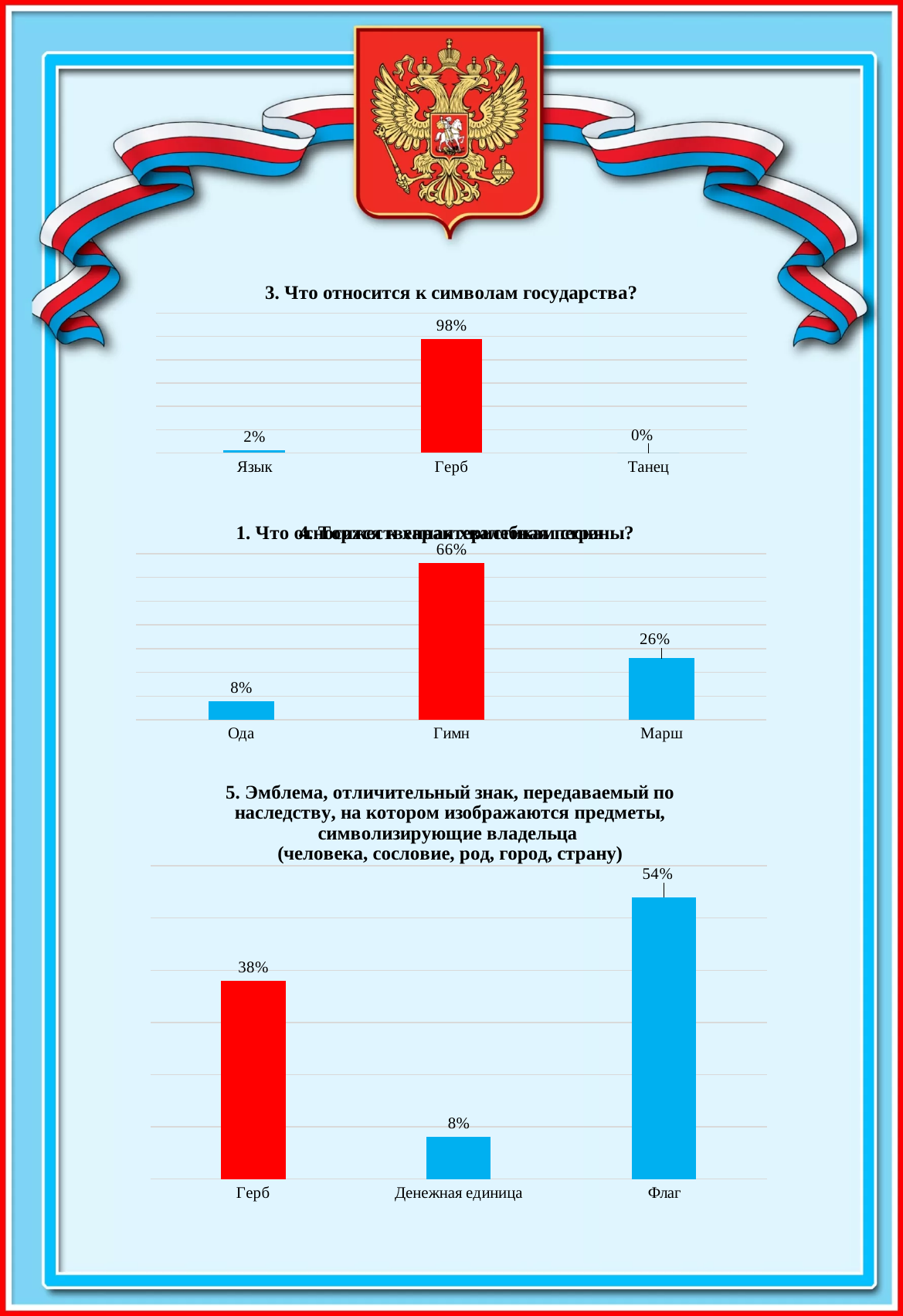
In the bottom chart, which category has the highest value? Флаг In the middle chart, which category has the highest value? Гимн In the middle chart, what is the value for Марш? 26% In the middle chart, what is the difference between the values for Гимн and Марш? 40% In the middle chart, which is larger, the value for Ода or the value for Марш? Марш In the top chart, which category has the lowest value? Танец In the bottom chart, what is the difference between the values for Флаг and Герб? 16% In the top chart, what is the difference between the values for Герб and Язык? 96% In the bottom chart, what is the value for Денежная единица? 8% In the top chart, what is the value for Герб? 98% What type of chart is the bottom chart? Bar chart How many categories are shown in the top chart? 3